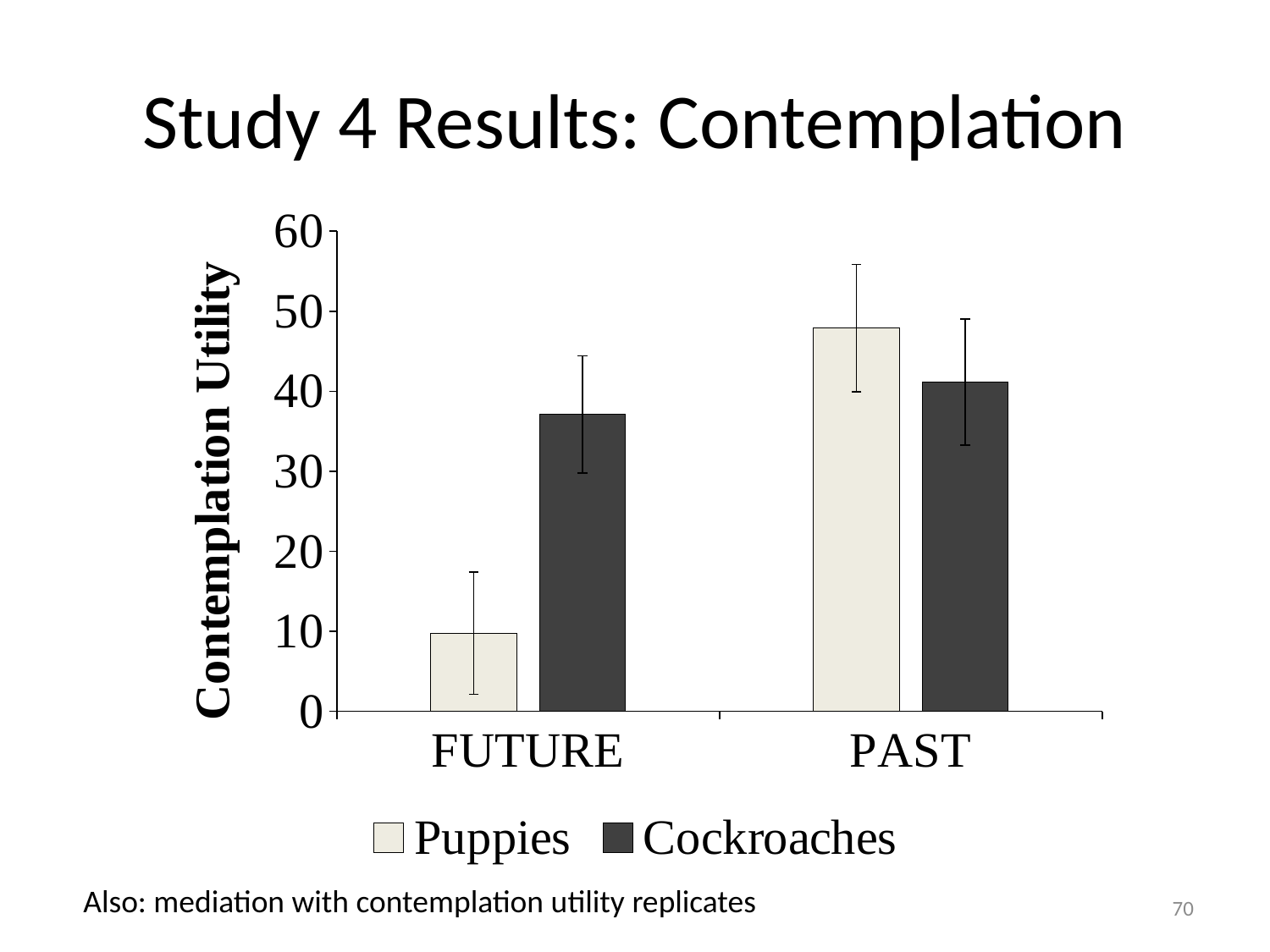
What is the label of the vertical axis? Contemplation Utility Which bar is the lowest in the chart? Puppies in FUTURE Which series is shown with the dark bars? Cockroaches Which bar is the highest in the chart? Puppies in PAST Is the value for Puppies in FUTURE greater or less than 20? less In the FUTURE category, which is larger, Puppies or Cockroaches? Cockroaches How many categories are shown on the x axis? 2 What kind of chart is shown on the slide? bar chart How many series does the legend list? 2 In the PAST category, which is larger, Puppies or Cockroaches? Puppies Is the value for Cockroaches in FUTURE greater or less than 30? greater Is the value for Puppies in PAST greater or less than 50? less